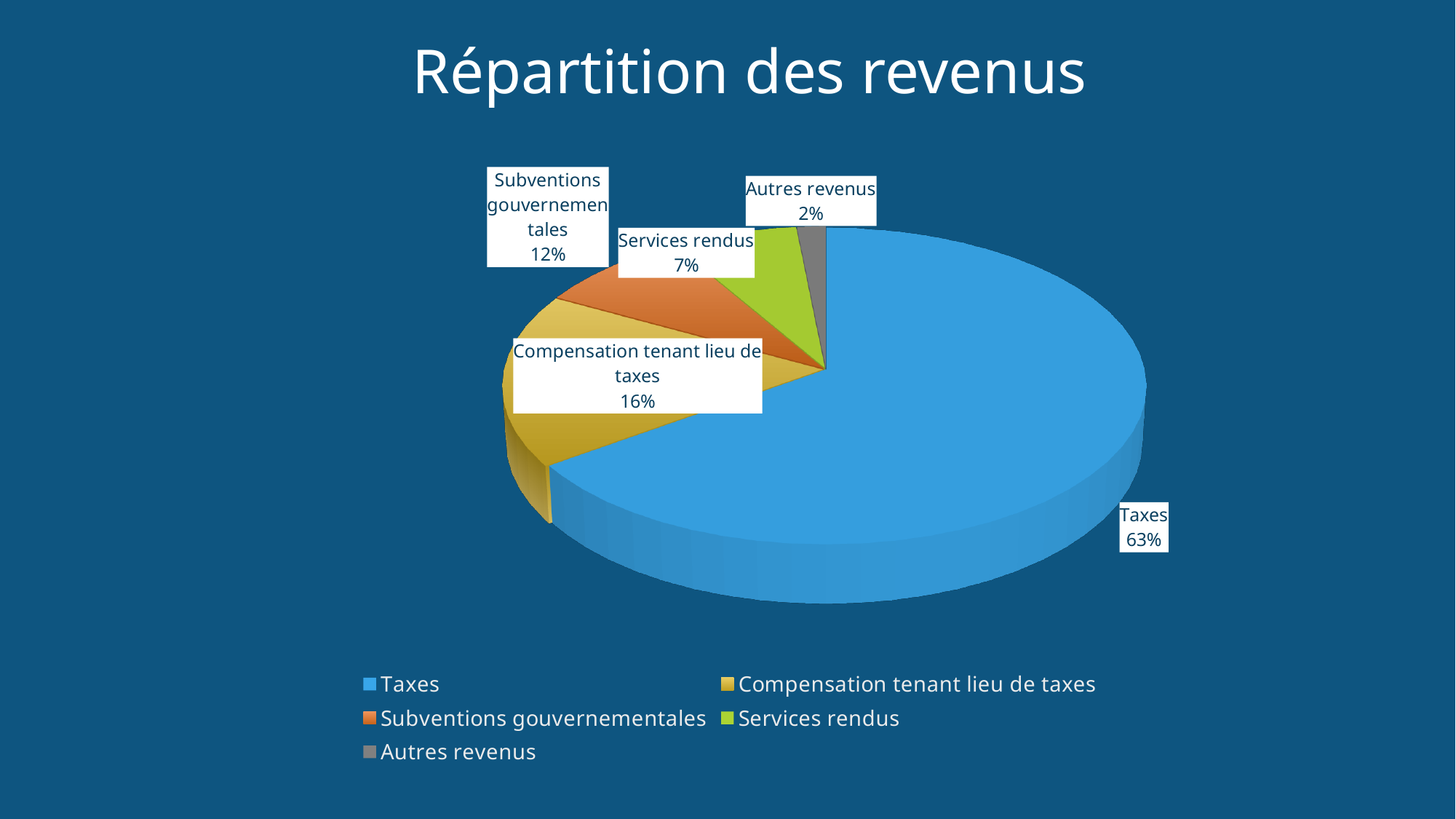
How many categories are shown in the pie chart? 5 What share of revenue comes from Taxes? 63% Which category has the smallest share of the pie? Autres revenus What is the difference in percentage points between Taxes and Compensation tenant lieu de taxes? 47 What percentage is shown for Compensation tenant lieu de taxes? 16% Which category has the largest share of the pie? Taxes What is the title of the chart? Répartition des revenus What percentage is shown for Services rendus? 7% What type of chart is shown on the slide? Pie chart What percentage is shown for Autres revenus? 2% Which is larger, Subventions gouvernementales or Services rendus? Subventions gouvernementales What percentage is shown for Subventions gouvernementales? 12%